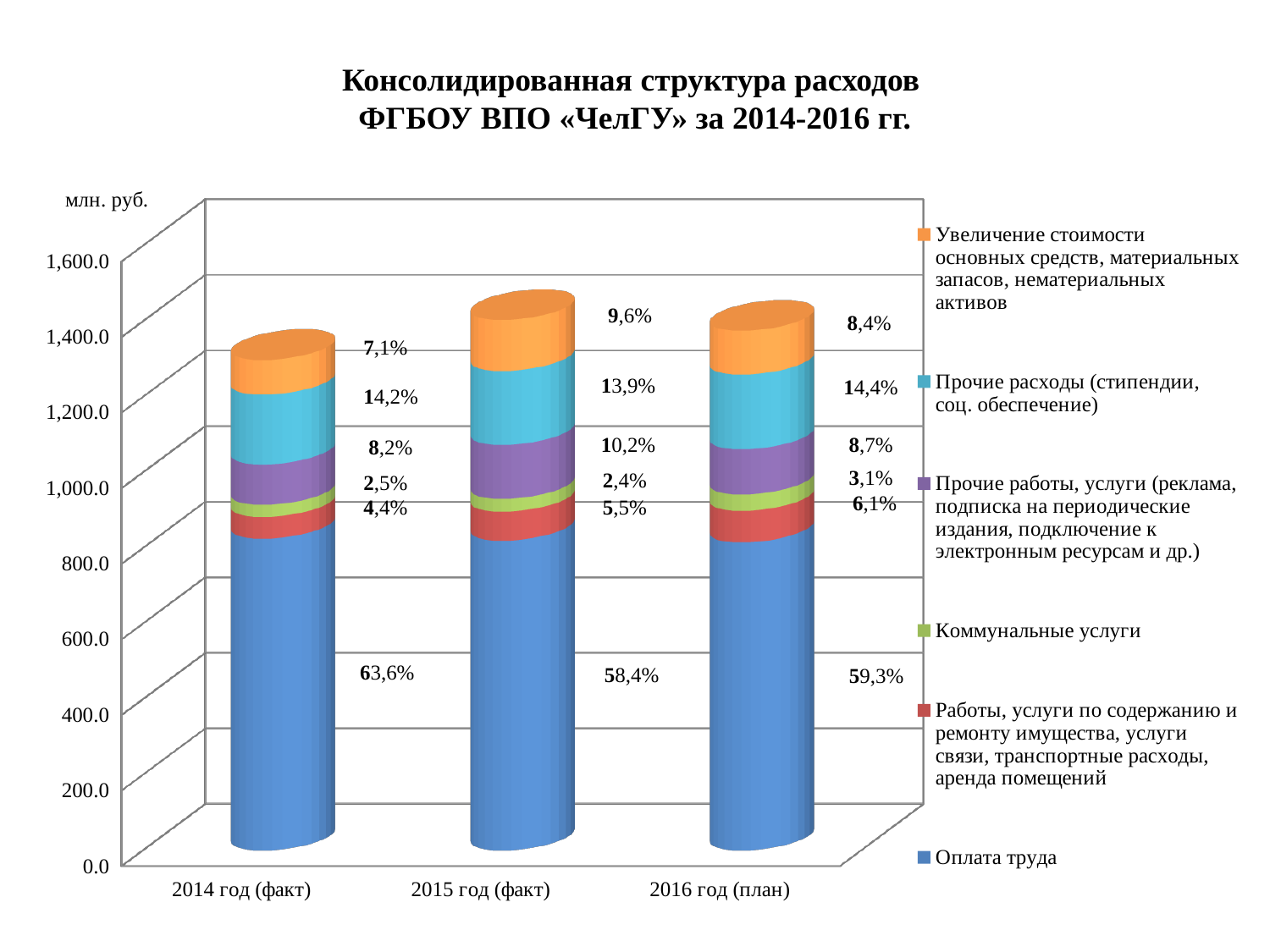
By how many percentage points did the share of Оплата труда fall from 2014 год (факт) to 2015 год (факт)? 5,2 What share of expenses was Увеличение стоимости основных средств, материальных запасов, нематериальных активов in 2014 год (факт)? 7,1% What share of expenses was Оплата труда in 2015 год (факт)? 58,4% Which is larger: the share of Прочие работы, услуги in 2015 год (факт) or in 2016 год (план)? 2015 год (факт) What share of expenses was Прочие расходы (стипендии, соц. обеспечение) in 2015 год (факт)? 13,9% What share of expenses is planned for Оплата труда in 2016 год (план)? 59,3% What share of expenses was Коммунальные услуги in 2016 год (план)? 3,1% In which year was the share of Оплата труда the highest? 2014 год (факт) In which year was the share of Увеличение стоимости основных средств, материальных запасов, нематериальных активов the lowest? 2014 год (факт) How many series does the legend list? 6 Is the total height of the 2014 год (факт) bar greater or less than 1,200.0 млн. руб.? greater What share of expenses was Оплата труда in 2014 год (факт)? 63,6%